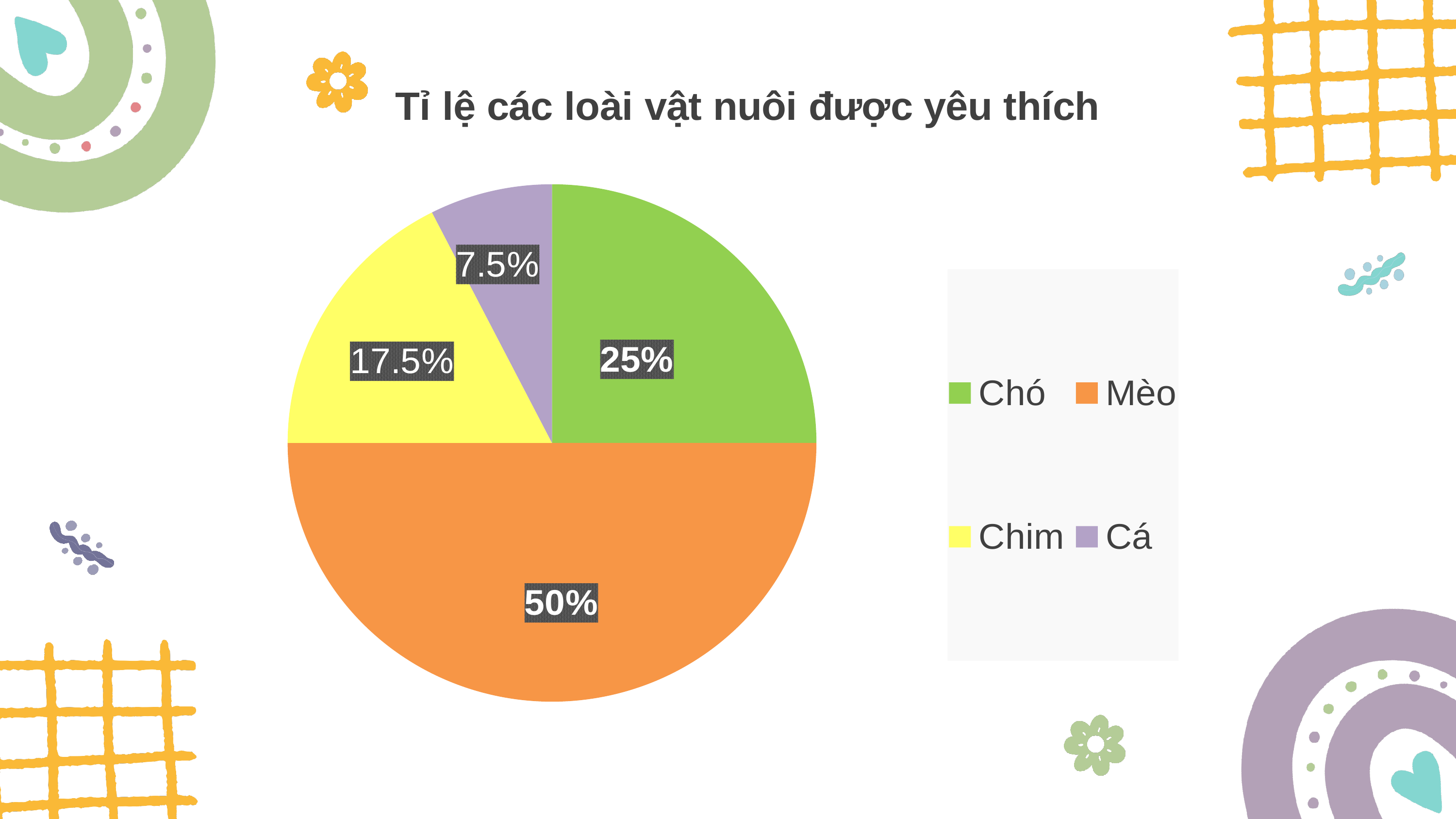
What percentage of the pie is Chim? 17.5% What colour is the slice for Chim? yellow Which is larger, the share for Chim or the share for Cá? Chim What kind of chart is shown on the slide? pie chart Which category has the largest slice of the pie? Mèo What is the title of the chart? Tỉ lệ các loài vật nuôi được yêu thích What percentage of the pie is Cá? 7.5% What percentage of the pie is Mèo? 50% Which category has the smallest slice of the pie? Cá How many categories does the pie chart have? 4 What percentage of the pie is Chó? 25% What is the difference between the shares of Mèo and Chó? 25%